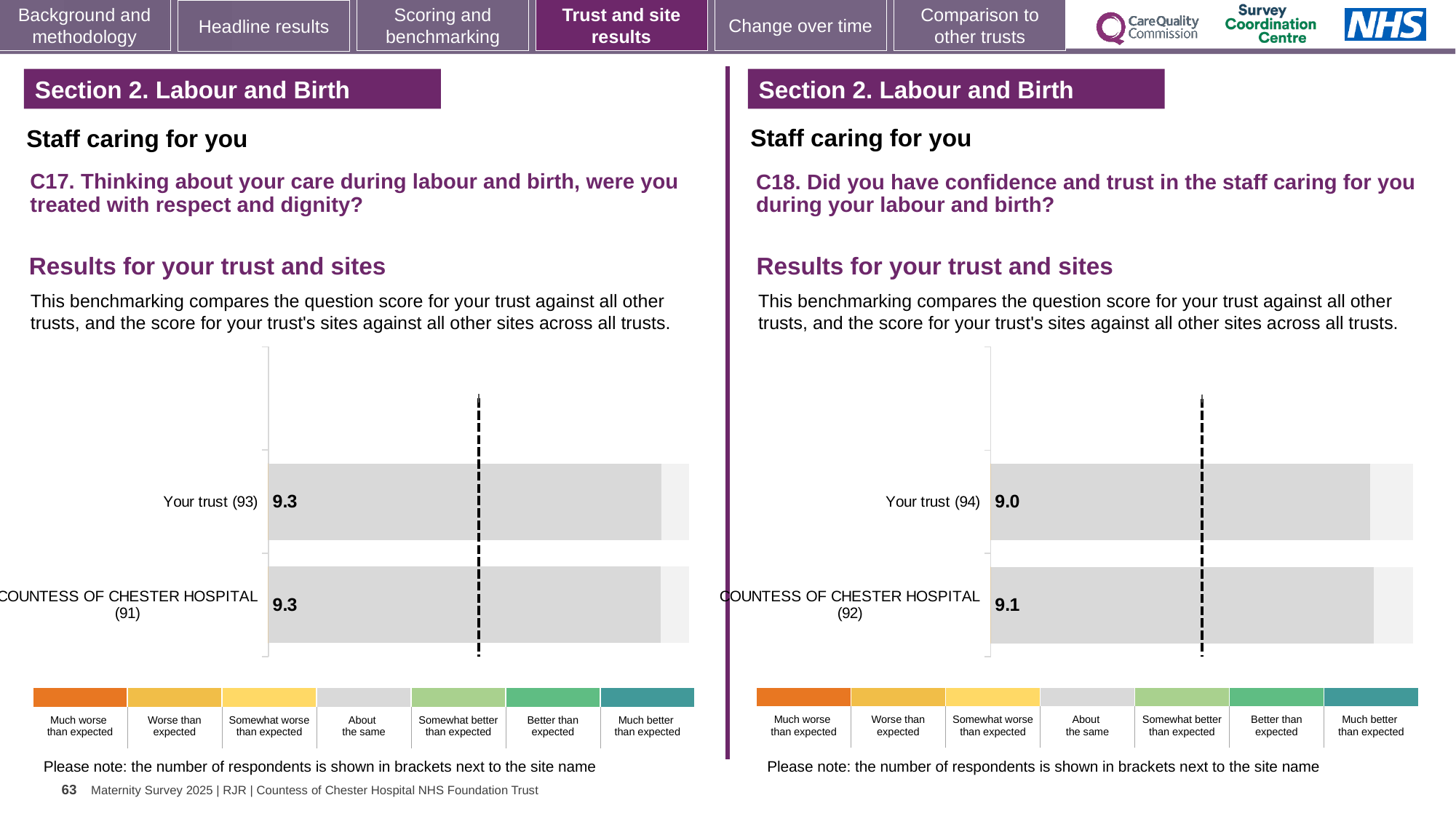
In the C17 chart on the left, how many respondents are shown in brackets for Your trust? 93 In the C18 chart on the right, what is the score for Countess of Chester Hospital? 9.1 In the C18 chart on the right, how many respondents are shown in brackets for Countess of Chester Hospital? 92 How many bars are plotted in the C18 chart on the right? 2 In the C17 chart on the left, what is the score for Countess of Chester Hospital? 9.3 In the C18 chart on the right, what is the difference between the Countess of Chester Hospital score and the Your trust score? 0.1 In the C18 chart on the right, what is the score for Your trust? 9.0 How many bars are plotted in the C17 chart on the left? 2 What type of chart is used for the C18 results on the right? Bar chart In the C17 chart on the left, what is the score for Your trust? 9.3 Is the Your trust score in the C18 chart on the right larger or smaller than the Your trust score in the C17 chart on the left? Smaller In the C17 chart on the left, what is the difference between the Your trust score and the Countess of Chester Hospital score? 0